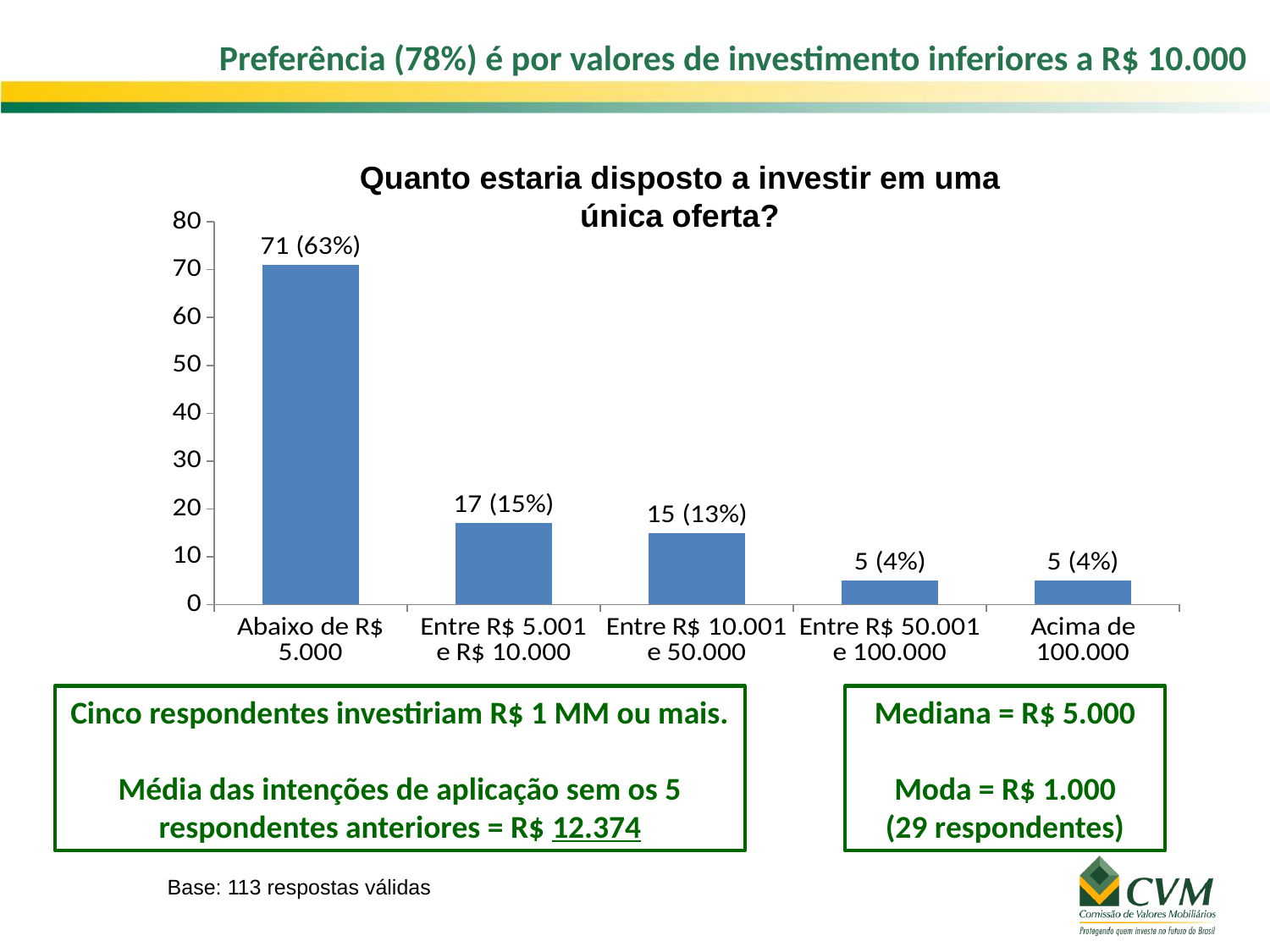
What kind of chart is shown? bar chart What is the maximum value shown on the y axis? 80 How many categories are shown on the x axis? 5 What is the value for 'Acima de 100.000'? 5 (4%) Which category has the highest value? Abaixo de R$ 5.000 Do the values rise or fall from left to right along the x axis? fall What is the value for 'Abaixo de R$ 5.000'? 71 (63%) What is the title of the chart? Quanto estaria disposto a investir em uma única oferta? Is the value for 'Entre R$ 50.001 e 100.000' greater or less than 10? less What is the difference between the values for 'Abaixo de R$ 5.000' and 'Entre R$ 5.001 e R$ 10.000'? 54 Which is larger, the value for 'Entre R$ 5.001 e R$ 10.000' or 'Entre R$ 10.001 e 50.000'? Entre R$ 5.001 e R$ 10.000 What is the value for 'Entre R$ 10.001 e 50.000'? 15 (13%)